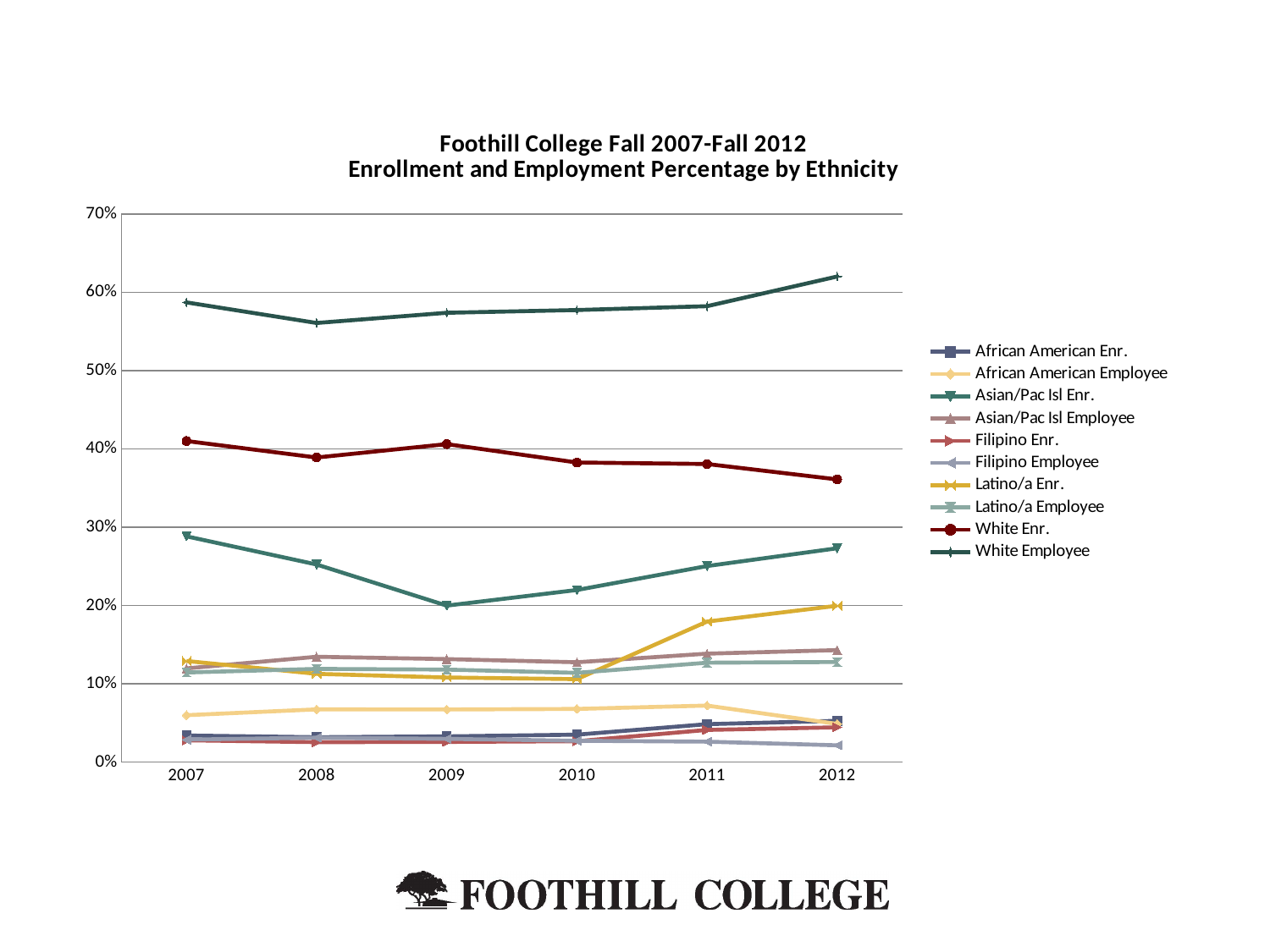
How many years are shown on the x axis? 6 How many series does the legend list? 10 In which year is Asian/Pac Isl Enr. at its lowest? 2009 What kind of chart is shown on the slide? line chart In 2009, which is larger, Asian/Pac Isl Enr. or Latino/a Enr.? Asian/Pac Isl Enr. Is the value for White Employee in 2012 greater or less than 60%? greater Is the value for Latino/a Enr. in 2012 greater or less than 10%? greater Overall, does White Enr. rise or fall from 2007 to 2012? fall Is the value for White Enr. in 2012 greater or less than 40%? less Which series has the lowest value in 2012? Filipino Employee Which series has the highest value in 2012? White Employee